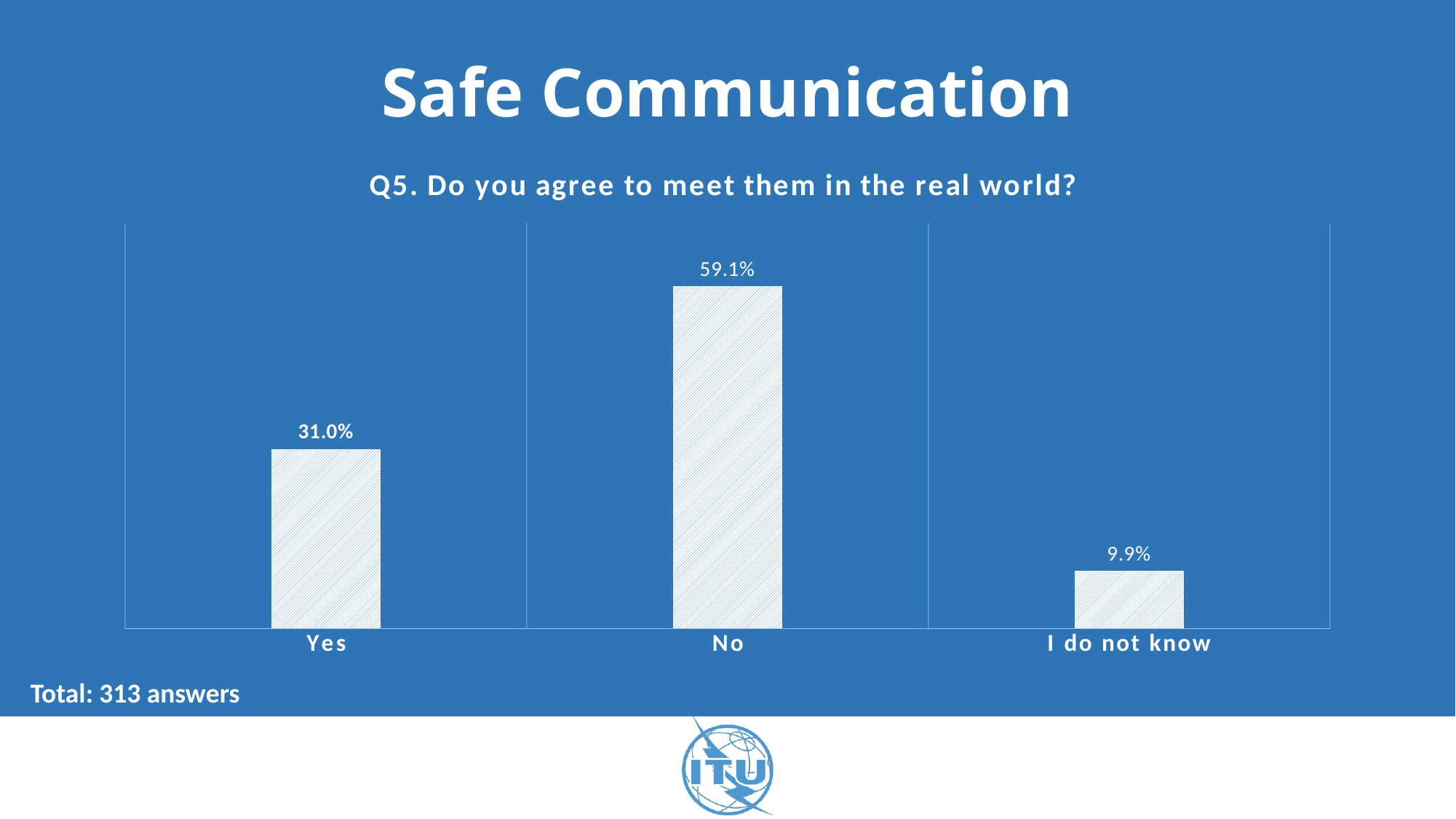
What percentage of respondents answered "Yes"? 31.0% What is the title of the chart? Q5. Do you agree to meet them in the real world? How many total answers does the slide report for this question? 313 What is the difference in percentage points between the "No" and "Yes" responses? 28.1 What type of chart is shown on the slide? Bar chart What percentage of respondents answered "No"? 59.1% How many response categories are shown in the chart? 3 Which is larger, the percentage for "Yes" or for "No"? No Which response category has the lowest percentage? I do not know What is the difference in percentage points between the "Yes" and "I do not know" responses? 21.1 Which response category has the highest percentage? No What percentage of respondents answered "I do not know"? 9.9%